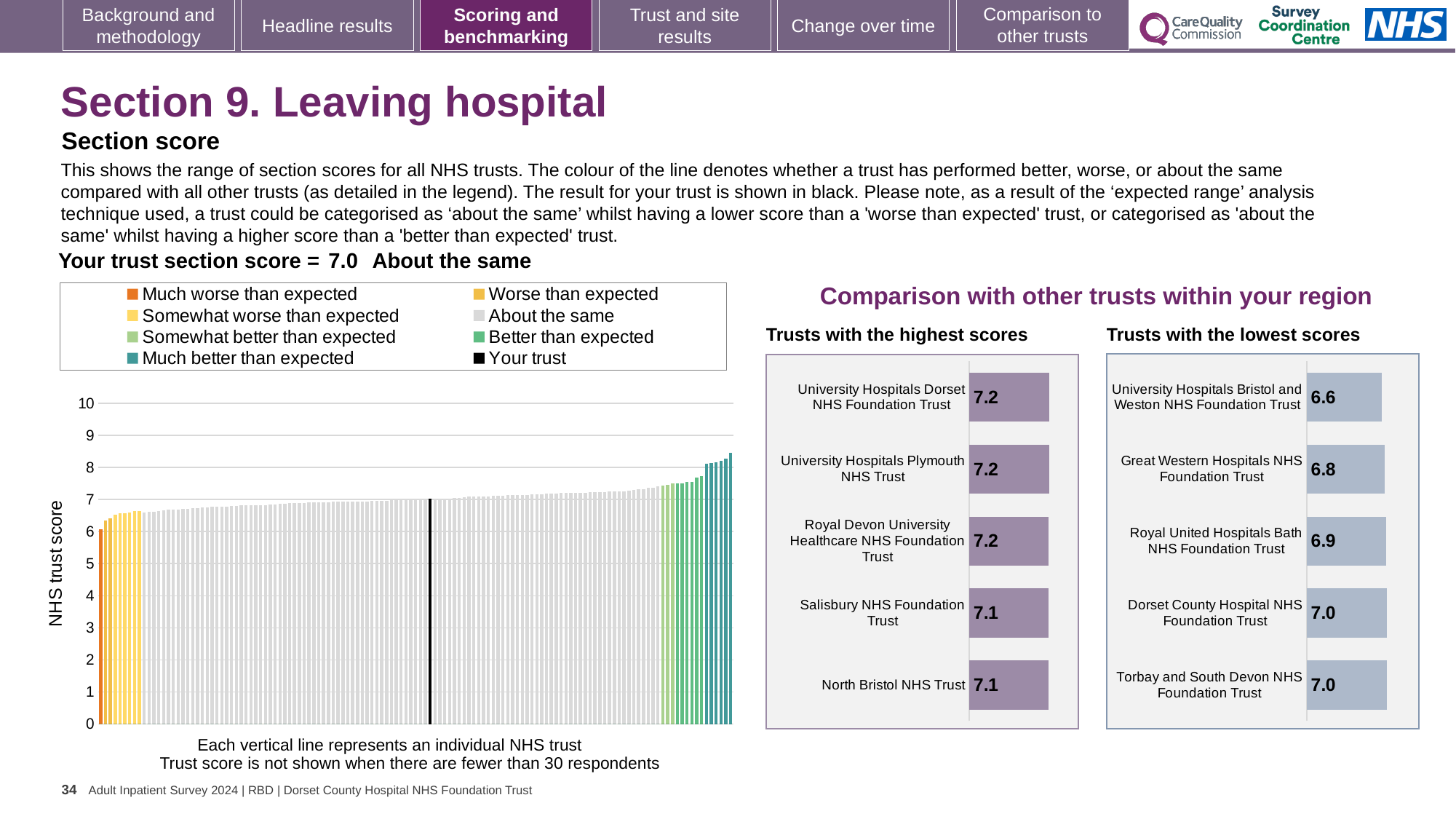
According to the slide, what is your trust's section score for Section 9, Leaving hospital? 7.0 In the 'Trusts with the lowest scores' chart, which trust has the lowest score? University Hospitals Bristol and Weston NHS Foundation Trust In the 'Trusts with the highest scores' chart, what is the score for Salisbury NHS Foundation Trust? 7.1 How many trusts are shown in the 'Trusts with the highest scores' chart? 5 In the 'Trusts with the lowest scores' chart, what is the score for Great Western Hospitals NHS Foundation Trust? 6.8 In the large chart of NHS trust scores on the left, do the values rise or fall from left to right along the x axis? Rise How many entries does the legend of the large NHS trust score chart on the left list? 8 In the 'Trusts with the lowest scores' chart, which has the higher score: Great Western Hospitals NHS Foundation Trust or Royal United Hospitals Bath NHS Foundation Trust? Royal United Hospitals Bath NHS Foundation Trust How many trusts are shown in the 'Trusts with the lowest scores' chart? 5 In the 'Trusts with the lowest scores' chart, what is the difference between the scores of Royal United Hospitals Bath NHS Foundation Trust and University Hospitals Bristol and Weston NHS Foundation Trust? 0.3 In the 'Trusts with the highest scores' chart, what is the difference between the scores of University Hospitals Dorset NHS Foundation Trust and North Bristol NHS Trust? 0.1 What kind of chart is the 'Trusts with the highest scores' chart? Bar chart